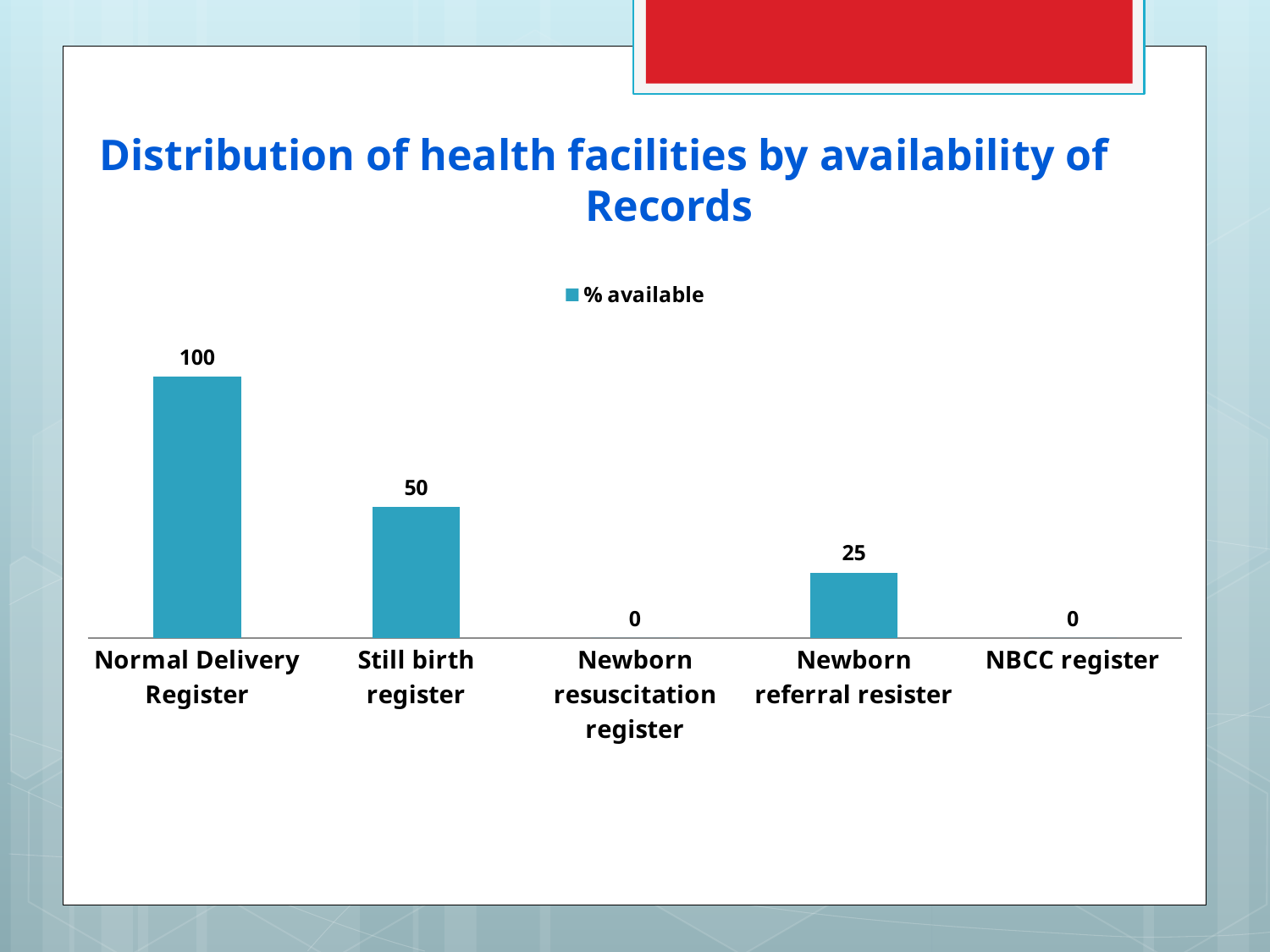
How many series does the legend list? 1 How many categories are shown on the chart? 5 What kind of chart is shown on the slide? Bar chart What is the % available value for Newborn referral resister? 25 What is the difference between the % available values for Normal Delivery Register and Still birth register? 50 Which is larger, the value for Still birth register or the value for Newborn referral resister? Still birth register What is the % available value for Normal Delivery Register? 100 What is the difference between the % available values for Still birth register and Newborn referral resister? 25 Which category has the highest % available value? Normal Delivery Register What is the % available value for NBCC register? 0 What is the % available value for Still birth register? 50 What is the title of the chart? Distribution of health facilities by availability of Records